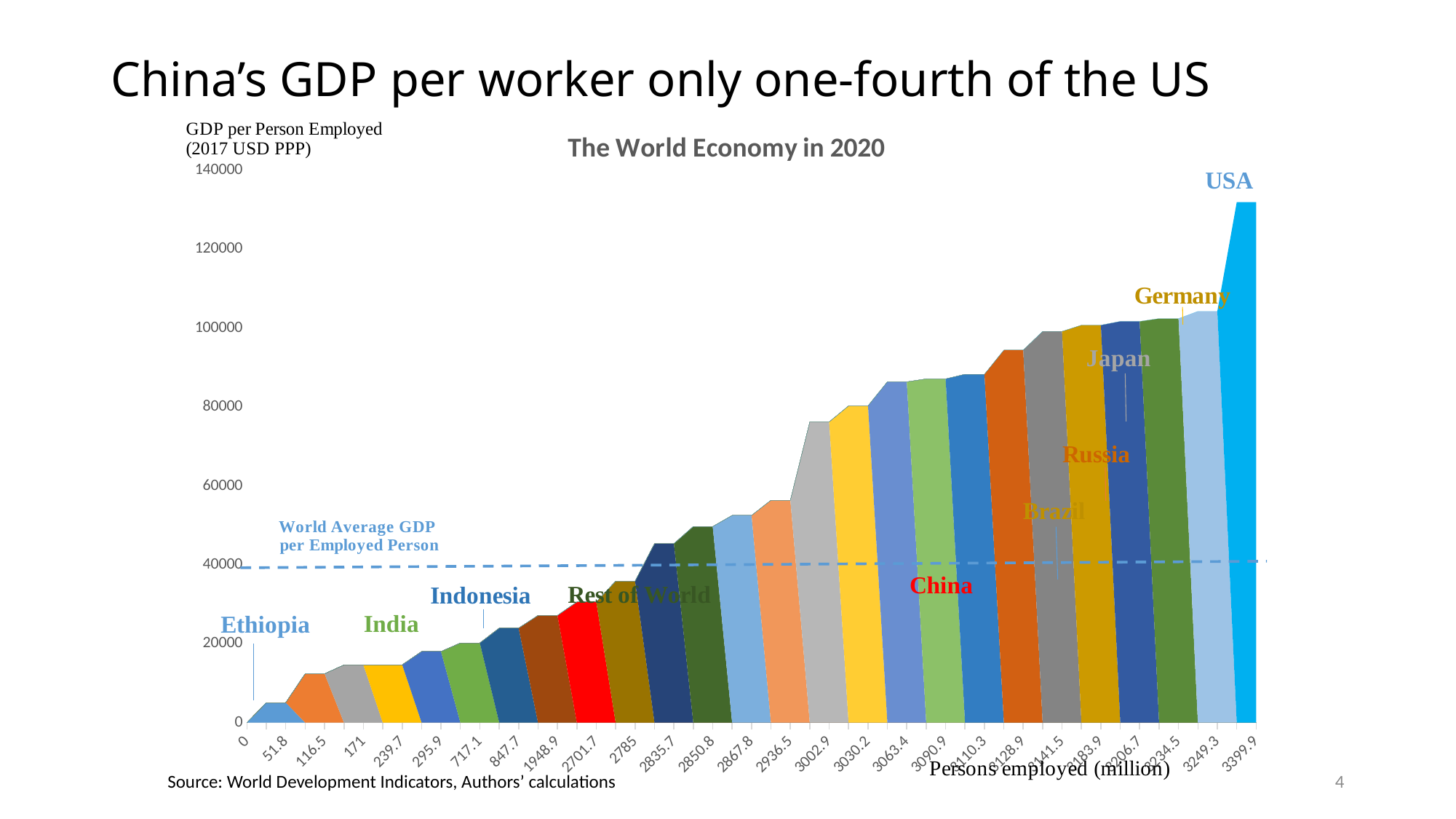
Is the GDP per person employed for Japan greater or less than 60000? greater Is the GDP per person employed for Ethiopia greater or less than 20000? less What does the horizontal dashed line on the chart represent? World Average GDP per Employed Person Which has a higher GDP per person employed, India or Ethiopia? India Is the GDP per person employed for the USA greater or less than 120000? greater Which labelled country has the lowest GDP per person employed? Ethiopia Which has a higher GDP per person employed, the USA or Germany? USA Which labelled country has the highest GDP per person employed? USA What kind of chart is shown on the slide? area chart What is the title of the chart? The World Economy in 2020 Do the values rise or fall moving from left to right along the x axis? rise